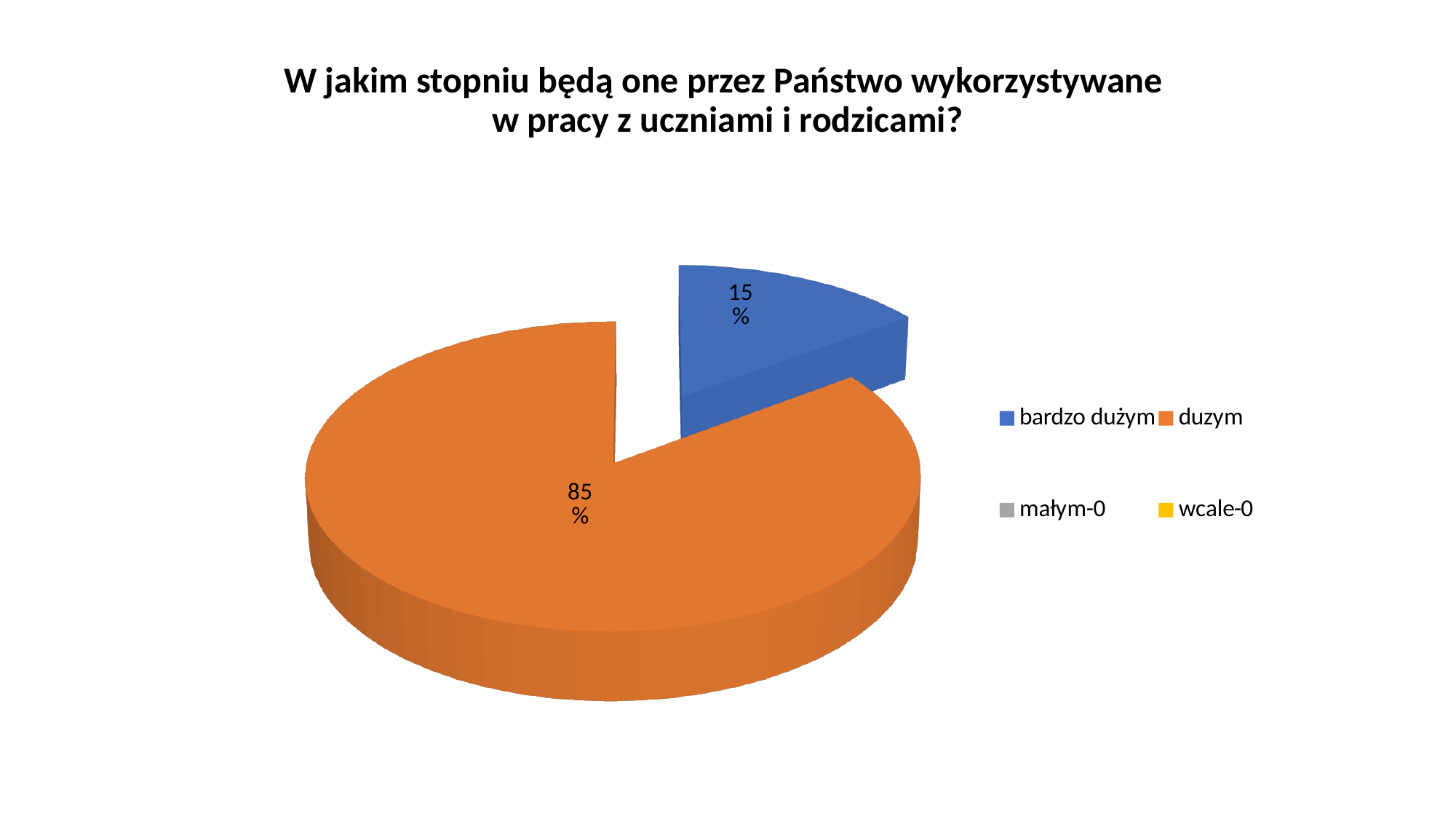
What value is shown in the legend for "małym"? 0 Which category has the largest share of the pie? duzym What percentage of the pie is labelled "bardzo dużym"? 15% Which of the two visible slices is larger, "bardzo dużym" or "duzym"? duzym What value is shown in the legend for "wcale"? 0 Is the share for "bardzo dużym" greater or less than 50%? less What colour is the "bardzo dużym" slice? blue What percentage of the pie is labelled "duzym"? 85% What is the title of the chart? W jakim stopniu będą one przez Państwo wykorzystywane w pracy z uczniami i rodzicami? How many entries does the legend list? 4 What kind of chart is shown on the slide? pie chart What is the difference in percentage points between the "duzym" and "bardzo dużym" slices? 70